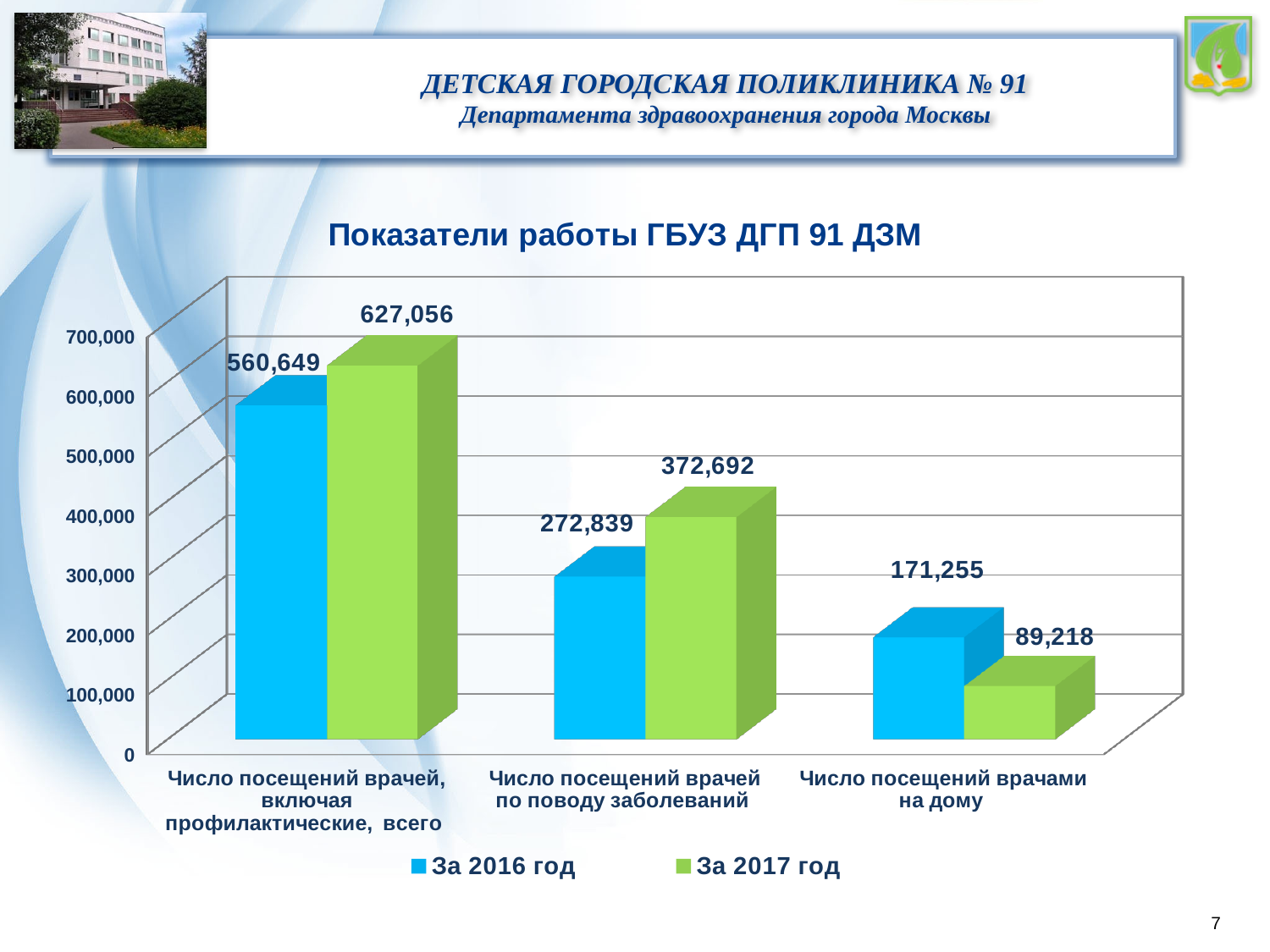
What is the title of the chart? Показатели работы ГБУЗ ДГП 91 ДЗМ What is the difference between the 2017 and 2016 values for "Число посещений врачей по поводу заболеваний"? 99,853 For "Число посещений врачами на дому", which series has the larger value, "За 2016 год" or "За 2017 год"? За 2016 год What is the value for "За 2017 год" in the category "Число посещений врачей по поводу заболеваний"? 372,692 Which category has the highest value for "За 2017 год"? Число посещений врачей, включая профилактические, всего What is the difference between the 2016 and 2017 values for "Число посещений врачами на дому"? 82,037 What is the value for "За 2016 год" in the category "Число посещений врачей, включая профилактические, всего"? 560,649 How many series does the legend list? 2 Which category has the lowest value for "За 2016 год"? Число посещений врачами на дому What is the value for "За 2017 год" in the category "Число посещений врачами на дому"? 89,218 What kind of chart is shown on the slide? Bar chart How many categories are shown on the x axis of the chart? 3